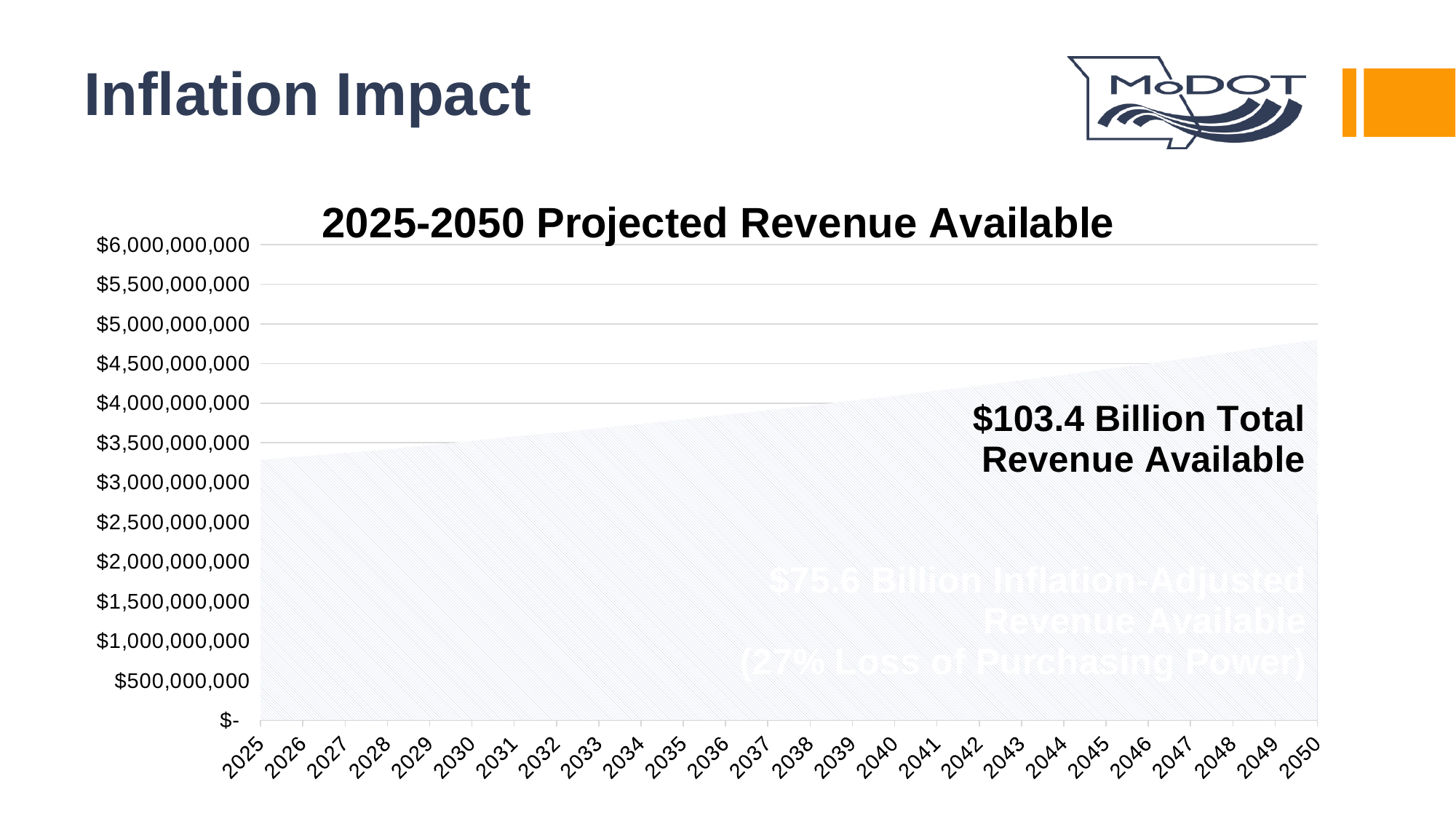
Is the projected revenue for 2050 greater or less than $5,000,000,000? less How many years are shown along the x axis of the chart? 26 Which year has the lowest projected revenue available? 2025 Which year has the larger projected revenue, 2030 or 2045? 2045 Which year has the highest projected revenue available? 2050 Is the projected revenue for 2050 greater or less than $4,500,000,000? greater Do the projected revenue values rise or fall from 2025 to 2050? Rise What is the title of the chart? 2025-2050 Projected Revenue Available According to the annotation on the chart, what is the total revenue available for 2025-2050? $103.4 Billion Is the projected revenue for 2025 greater or less than $3,500,000,000? less What kind of chart is shown on the slide? Area chart